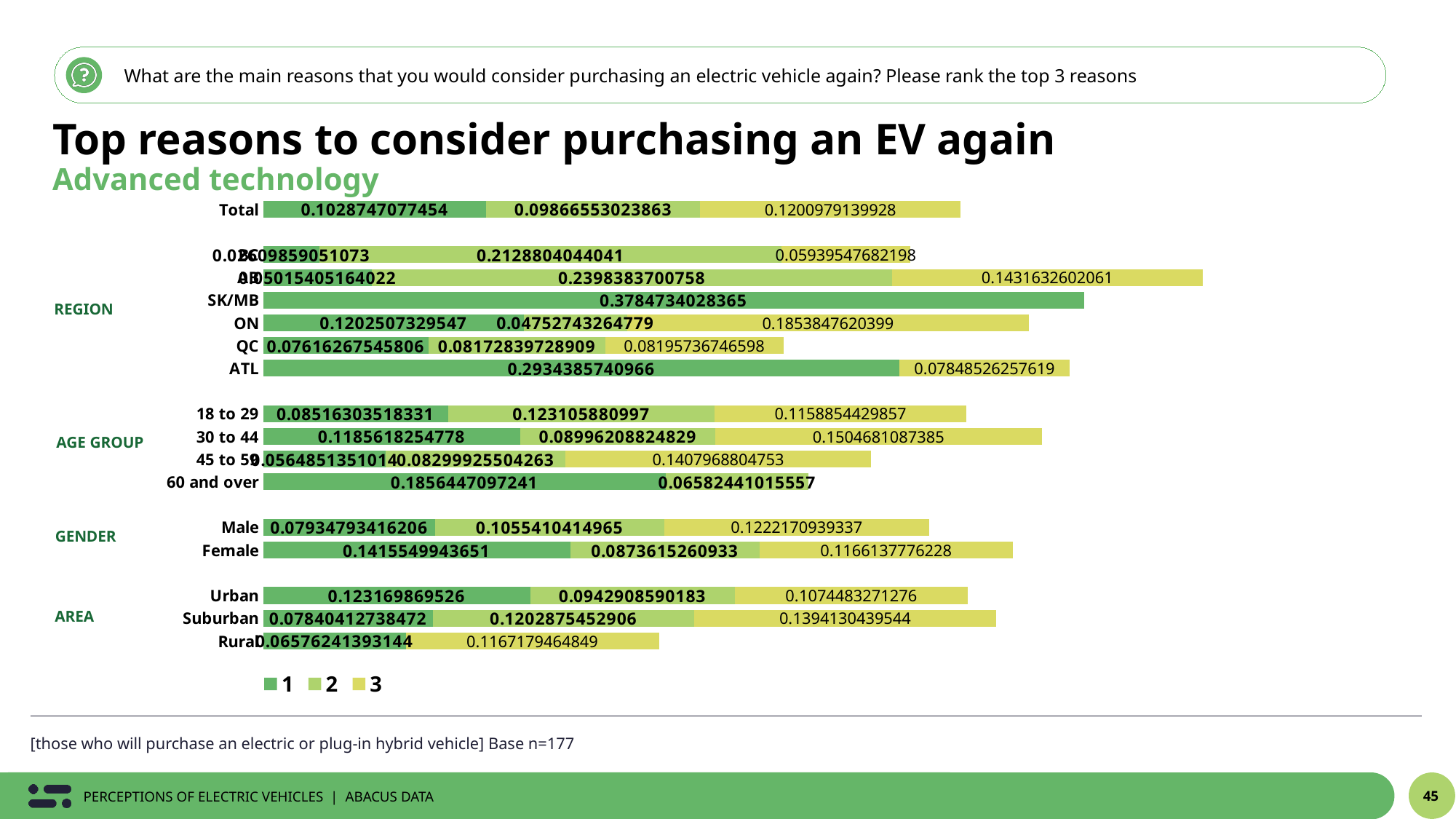
What kind of chart is shown on the slide? Stacked bar chart How many series does the legend list? 3 What is the subtitle of the chart shown in green below the main title? Advanced technology What is the value of series 3 for ON? 0.1853847620399 What is the value of series 1 for SK/MB? 0.3784734028365 What is the value of series 1 for Total? 0.1028747077454 What is the difference between the series 3 value and the series 1 value for Total? 0.0172232062474 What is the value of series 1 for Female? 0.1415549943651 Which is larger, the series 1 value for Male or the series 1 value for Female? Female Which category has the largest single series 1 segment? SK/MB What is the total of the stacked bar for Total? 0.32163815197683 What is the value of series 2 for Suburban? 0.1202875452906